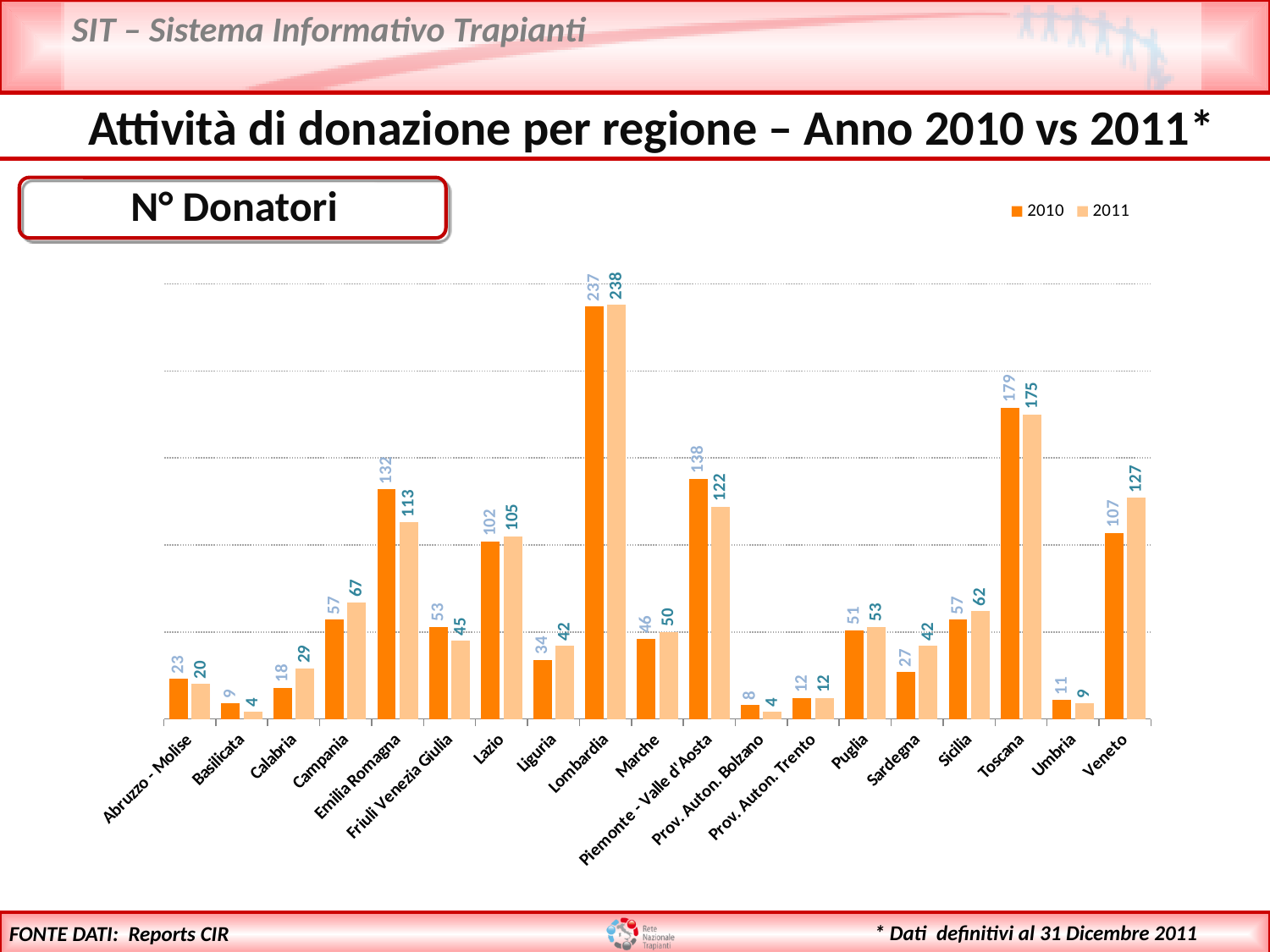
What is the difference between the 2011 values for Toscana and Veneto? 48 What is the number of donors for Veneto in 2011? 127 Which is larger for Sardegna, the 2010 value or the 2011 value? 2011 How many regions are shown on the x axis? 19 What type of chart is shown on the slide? bar chart How many series does the legend list? 2 Which region has the highest number of donors in 2010? Lombardia What is the number of donors for Lombardia in 2011? 238 What is the title shown in the box above the chart? N° Donatori Which region has the lowest number of donors in 2011? Basilicata and Prov. Auton. Bolzano (both 4) What is the number of donors for Emilia Romagna in 2010? 132 What is the difference between the 2010 and 2011 values for Piemonte - Valle d'Aosta? 16